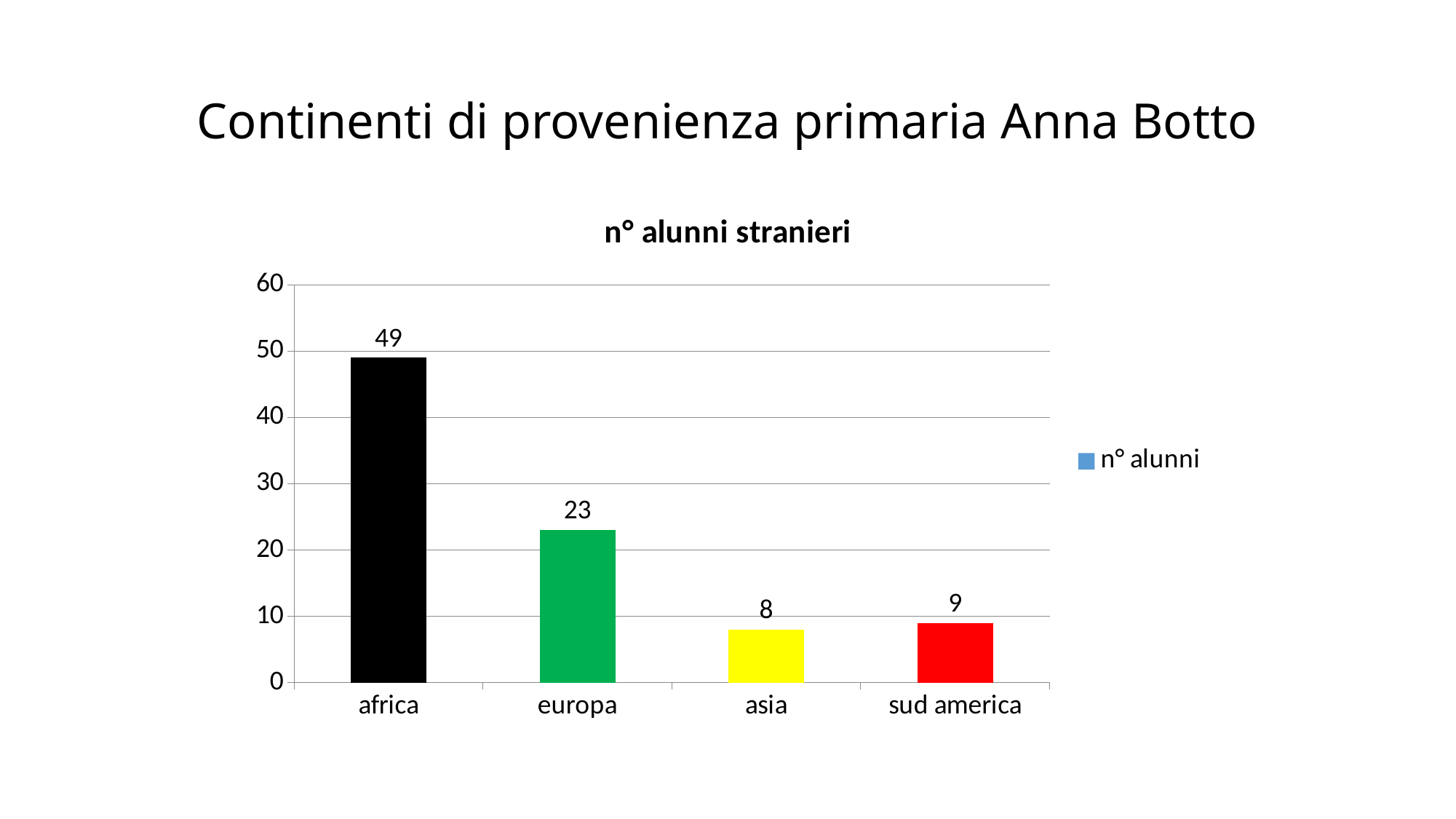
How many categories are shown on the x axis? 4 Is the value for africa greater or less than 40? greater What is the value for sud america? 9 Which is larger, the value for europa or the value for sud america? europa Which category has the lowest value? asia What is the value for europa? 23 What is the difference between the values for africa and europa? 26 What is the title of the chart? n° alunni stranieri What is the value for asia? 8 What kind of chart is shown on the slide? bar chart What is the value for africa? 49 Which category has the highest value? africa